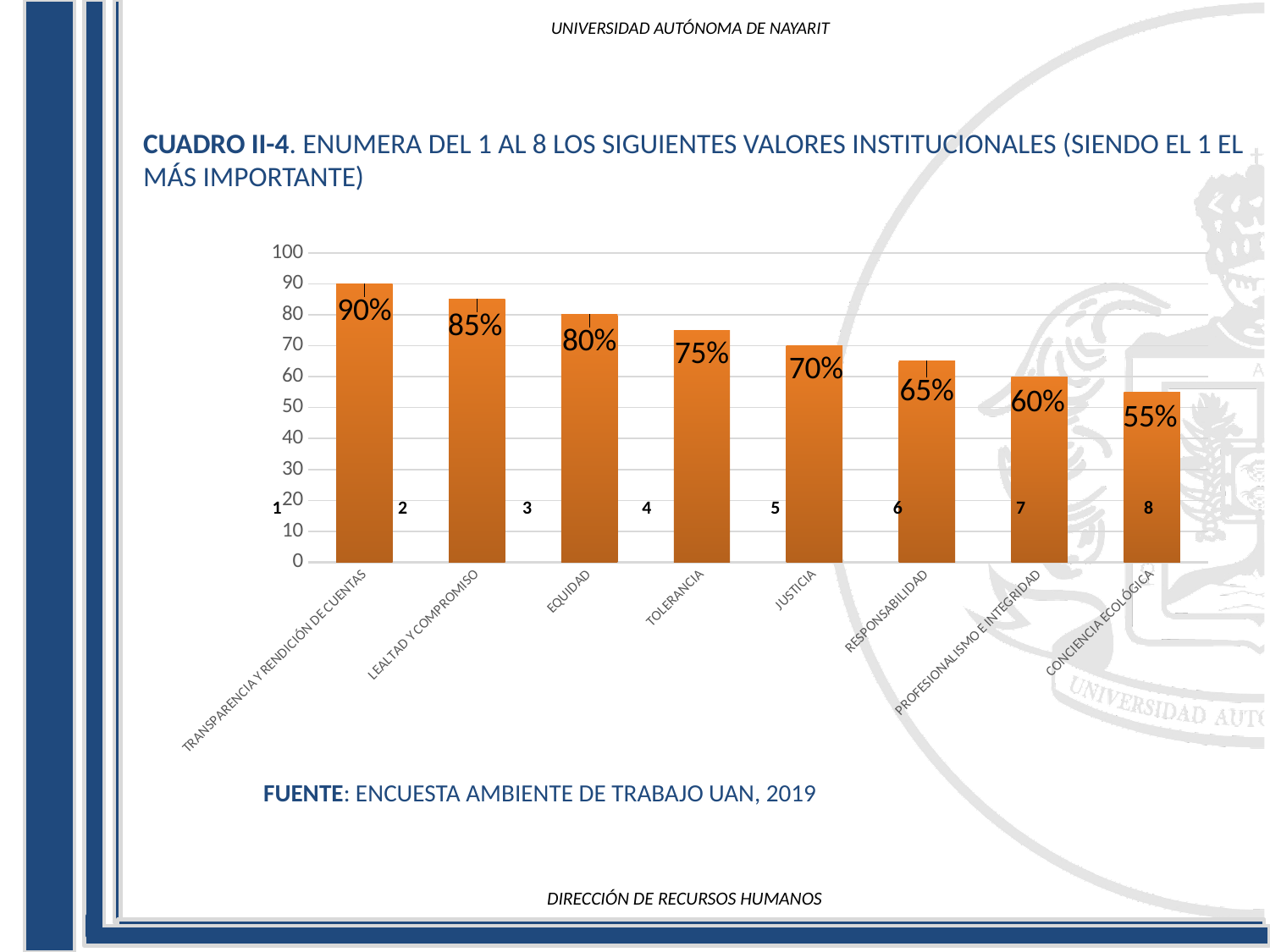
What is the difference between the values for LEALTAD Y COMPROMISO and RESPONSABILIDAD? 20% What kind of chart is shown on the slide? Bar chart What is the value for CONCIENCIA ECOLÓGICA? 55% How many categories are shown in the chart? 8 What source is cited below the chart? ENCUESTA AMBIENTE DE TRABAJO UAN, 2019 Do the values rise or fall from left to right along the x axis? Fall Which is larger, the value for TOLERANCIA or the value for PROFESIONALISMO E INTEGRIDAD? TOLERANCIA What is the value for JUSTICIA? 70% What is the value for EQUIDAD? 80% Which category has the highest value? TRANSPARENCIA Y RENDICIÓN DE CUENTAS What is the value for TRANSPARENCIA Y RENDICIÓN DE CUENTAS? 90% Which category has the lowest value? CONCIENCIA ECOLÓGICA